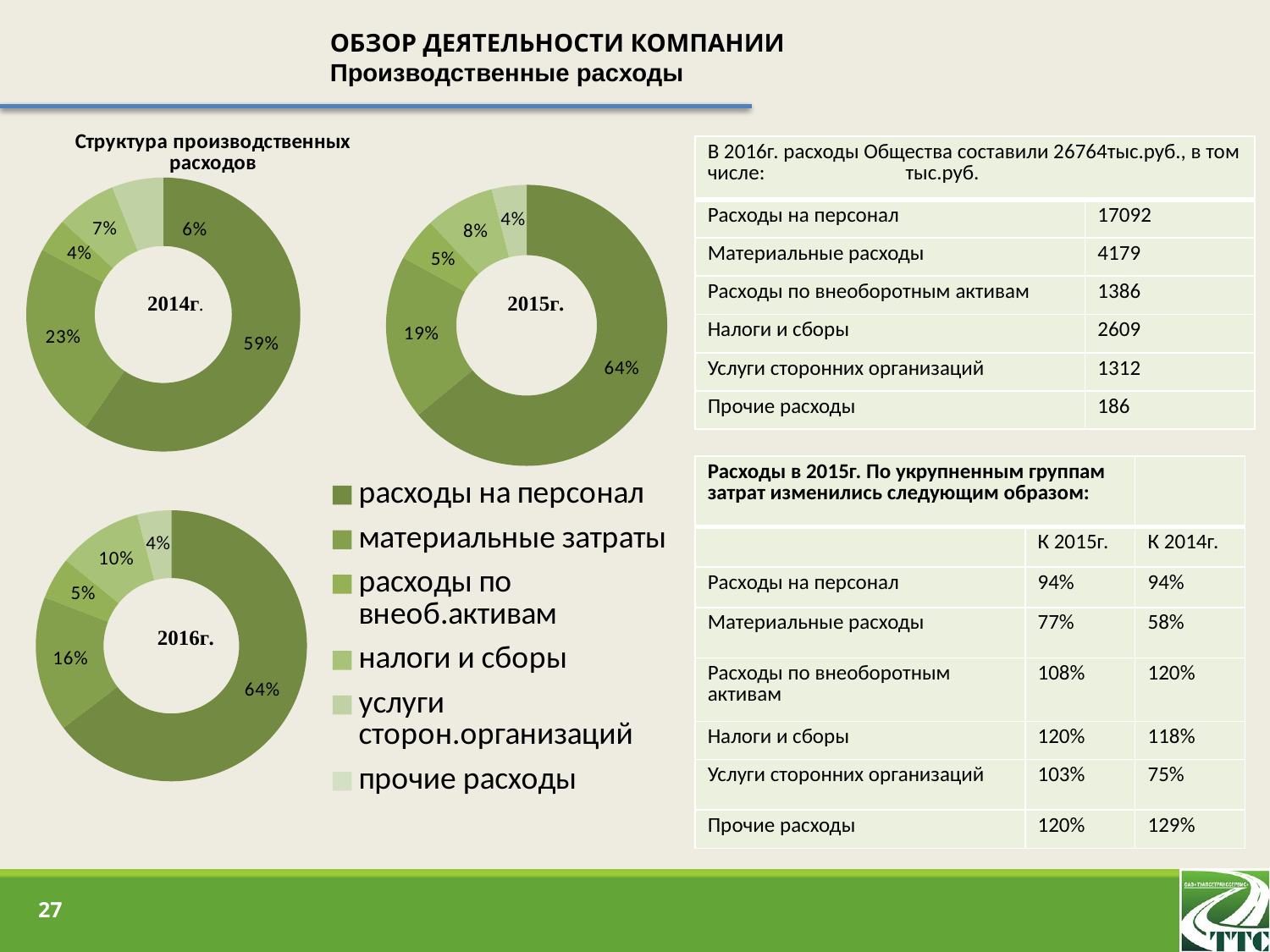
In the 2015 chart, what share of production expenses is расходы на персонал? 64% Which is larger: the share of материальные затраты in the 2014 chart or in the 2016 chart? 2014 (23%) In the 2016 chart, what share of production expenses is материальные затраты? 16% What kind of chart is used to show the structure of production expenses for 2014, 2015 and 2016? Doughnut (pie) chart In the 2016 chart, what share of production expenses is налоги и сборы? 10% In the 2016 chart, which category has the largest share? расходы на персонал What is the title of the group of doughnut charts on the left of the slide? Структура производственных расходов How many categories does the legend of the expense structure charts list? 6 In the 2014 chart, what share of production expenses is расходы на персонал? 59% In the 2015 chart, what share of production expenses is материальные затраты? 19% In the 2014 chart, what share of production expenses is материальные затраты? 23% By how many percentage points did the share of расходы на персонал change from the 2014 chart (59%) to the 2015 chart (64%)? 5 percentage points